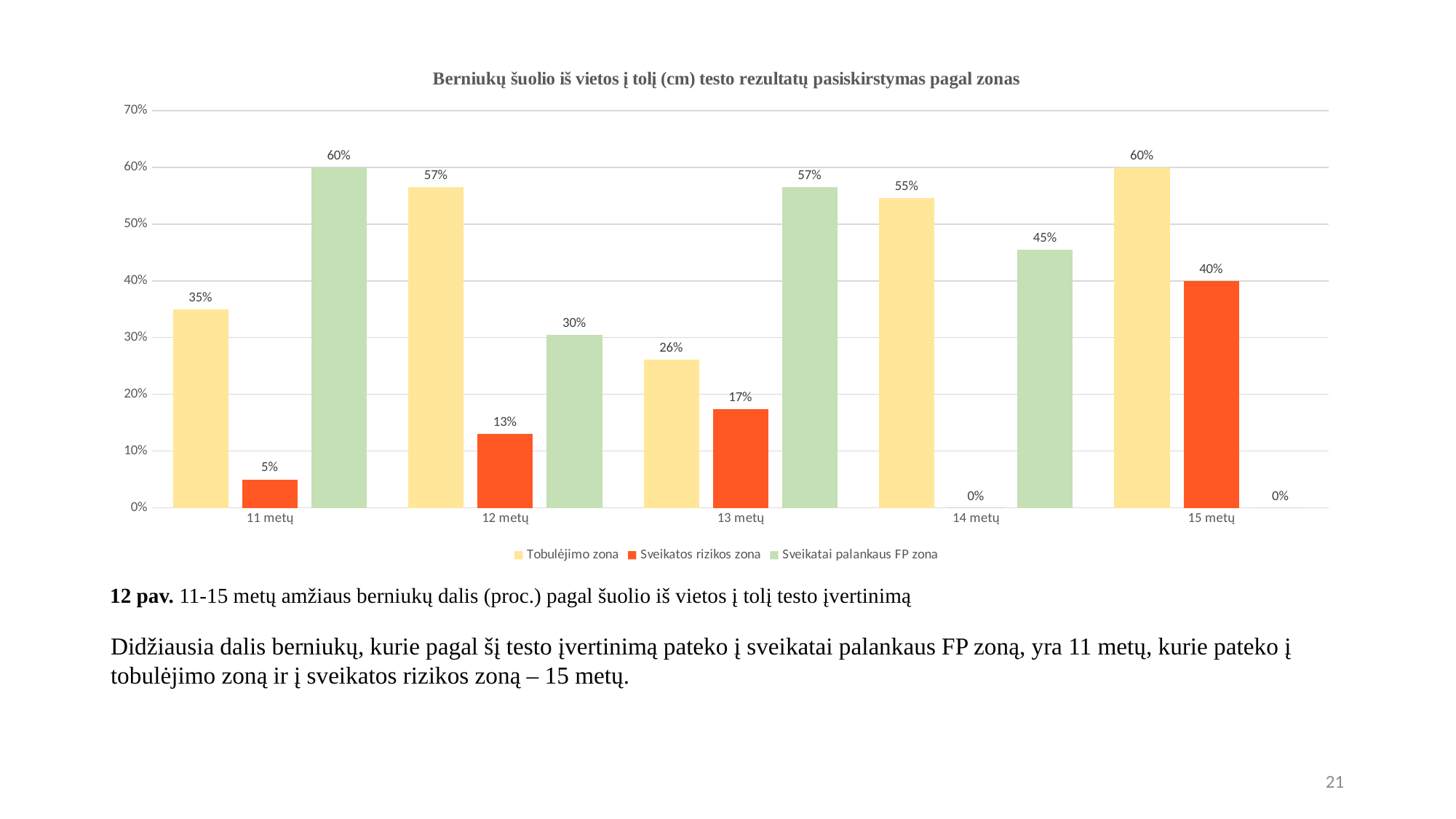
Which age group has the lowest value for Tobulėjimo zona? 13 metų How many age groups are shown on the x axis? 5 What is the value for Sveikatos rizikos zona at 15 metų? 40% Which age group has the highest value for Sveikatos rizikos zona? 15 metų Which age group has the highest value for Sveikatai palankaus FP zona? 11 metų At 14 metų, which is larger: Tobulėjimo zona or Sveikatai palankaus FP zona? Tobulėjimo zona What is the difference between Tobulėjimo zona and Sveikatai palankaus FP zona at 12 metų? 27 percentage points How many series does the legend list? 3 What is the value for Tobulėjimo zona at 11 metų? 35% What kind of chart is shown on the slide? Bar chart What is the value for Sveikatos rizikos zona at 14 metų? 0% What is the value for Sveikatai palankaus FP zona at 13 metų? 57%